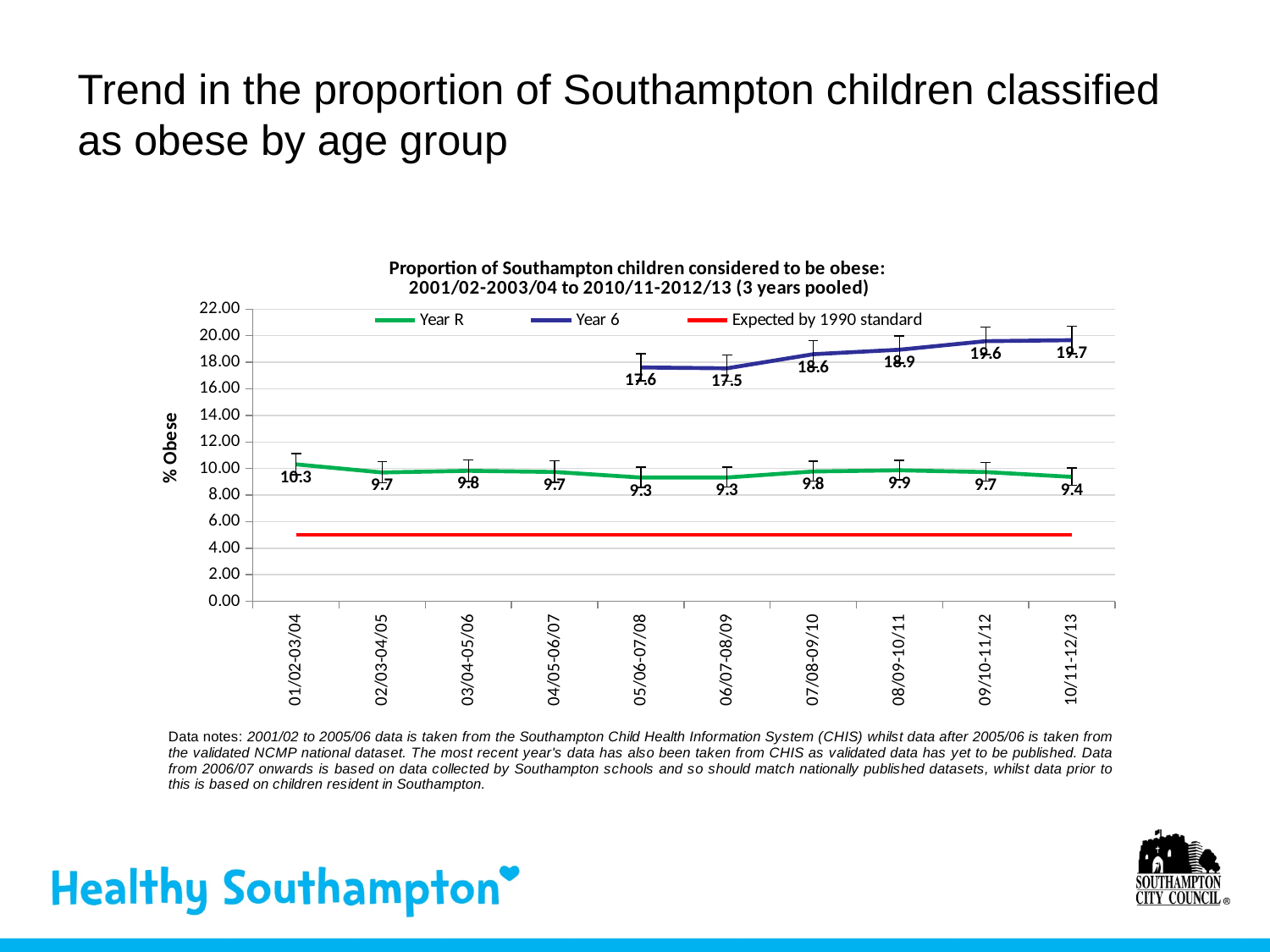
What kind of chart is shown on the slide? line chart In which period is the Year R value highest? 01/02-03/04 How many time periods are shown on the x axis? 10 In which period is the Year 6 value lowest? 06/07-08/09 Which is larger in 07/08-09/10, the Year 6 value or the Year R value? Year 6 Is the value of the Expected by 1990 standard line greater or less than 6.00? less What is the difference between the Year 6 value for 10/11-12/13 and for 05/06-07/08? 2.1 What is the Year R value for 08/09-10/11? 9.9 Does the Year 6 line rise or fall from 05/06-07/08 to 10/11-12/13? rise How many series does the chart legend list? 3 What is the Year R value for 01/02-03/04? 10.3 What is the Year 6 value for 10/11-12/13? 19.7